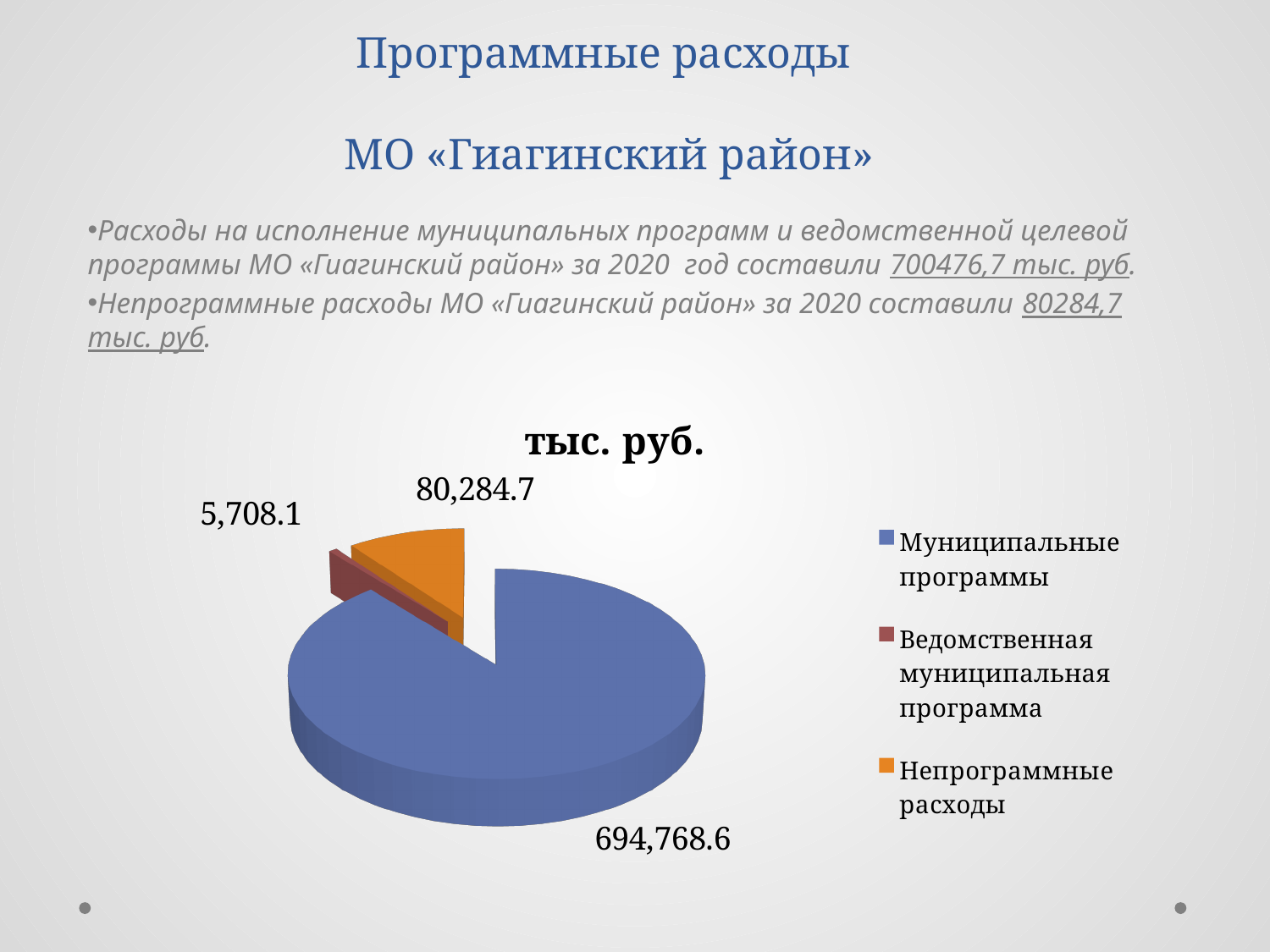
What colour is the slice for Непрограммные расходы? Orange What is the value for Муниципальные программы? 694,768.6 What is the value for Ведомственная муниципальная программа? 5,708.1 How many slices does the pie chart have? 3 What is the title of the chart? тыс. руб. Which is larger, Непрограммные расходы or Ведомственная муниципальная программа? Непрограммные расходы How many entries does the chart legend list? 3 What is the difference between Муниципальные программы and Непрограммные расходы? 614,483.9 What is the value for Непрограммные расходы? 80,284.7 Which category has the smallest slice of the pie? Ведомственная муниципальная программа Which category has the largest slice of the pie? Муниципальные программы What kind of chart is shown on the slide? Pie chart